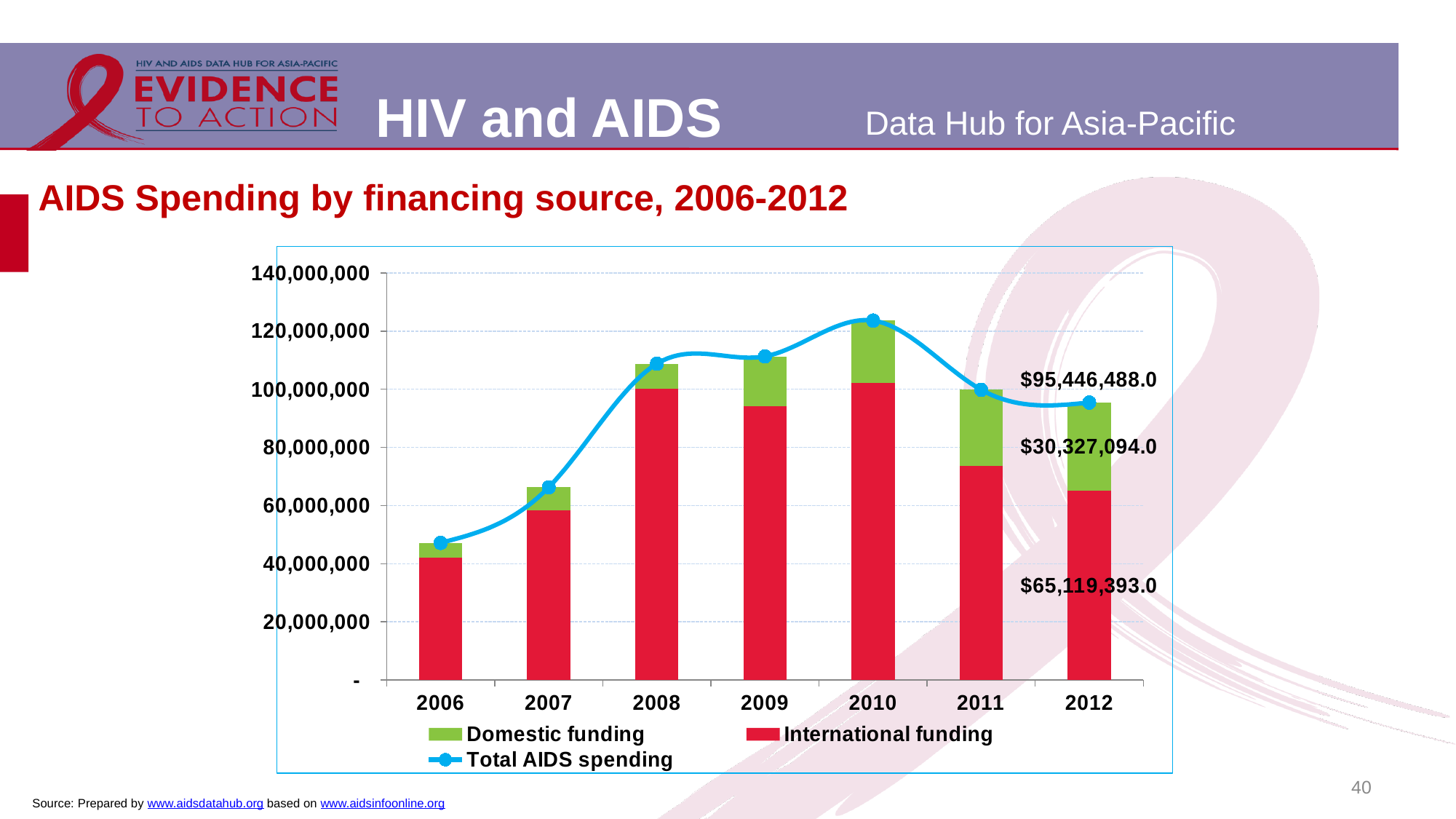
Which year has the highest Total AIDS spending? 2010 How many series does the legend list? 3 In 2012, which is larger: International funding or Domestic funding? International funding What is the Total AIDS spending value labelled for 2012? $95,446,488.0 Is the Total AIDS spending for 2010 greater or less than 120,000,000? greater What is the International funding value labelled for 2012? $65,119,393.0 What is the difference between International funding and Domestic funding in 2012? $34,792,299.0 What is the Domestic funding value labelled for 2012? $30,327,094.0 Which year has the lowest Total AIDS spending? 2006 What kind of chart is this? Bar chart with a line Is the Total AIDS spending for 2006 greater or less than 60,000,000? less How many years are shown on the x axis? 7